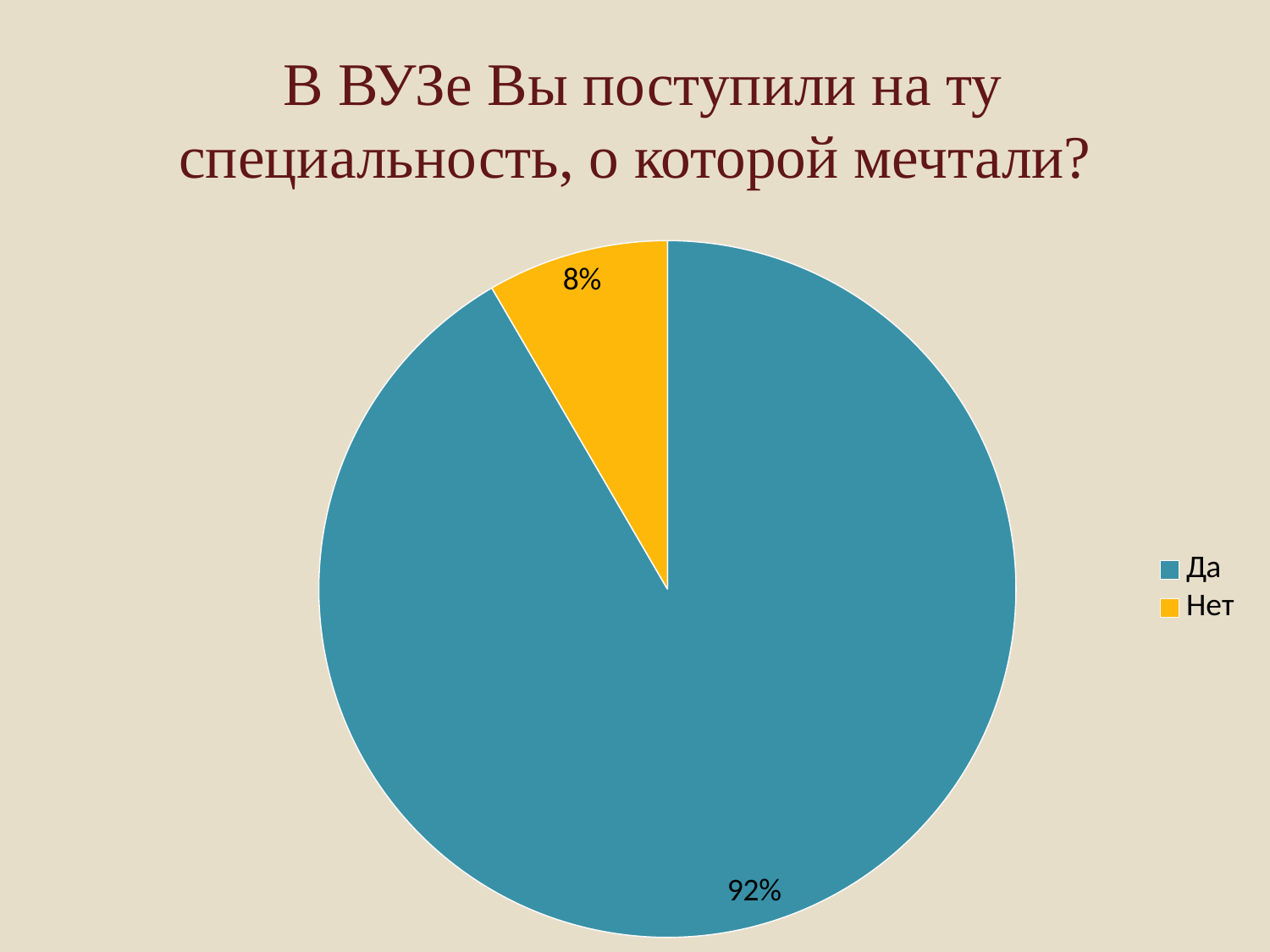
What share of the pie does "Нет" represent? 8% What colour is the "Нет" slice? yellow What is the difference in percentage points between the "Да" and "Нет" slices? 84 What share of the pie does "Да" represent? 92% Which category has the smallest slice of the pie? Нет What is the title of the chart? В ВУЗе Вы поступили на ту специальность, о которой мечтали? Which category has the largest slice of the pie? Да What kind of chart is shown on the slide? pie chart Which is larger, the "Да" slice or the "Нет" slice? Да How many entries does the legend list? 2 How many categories does the pie chart have? 2